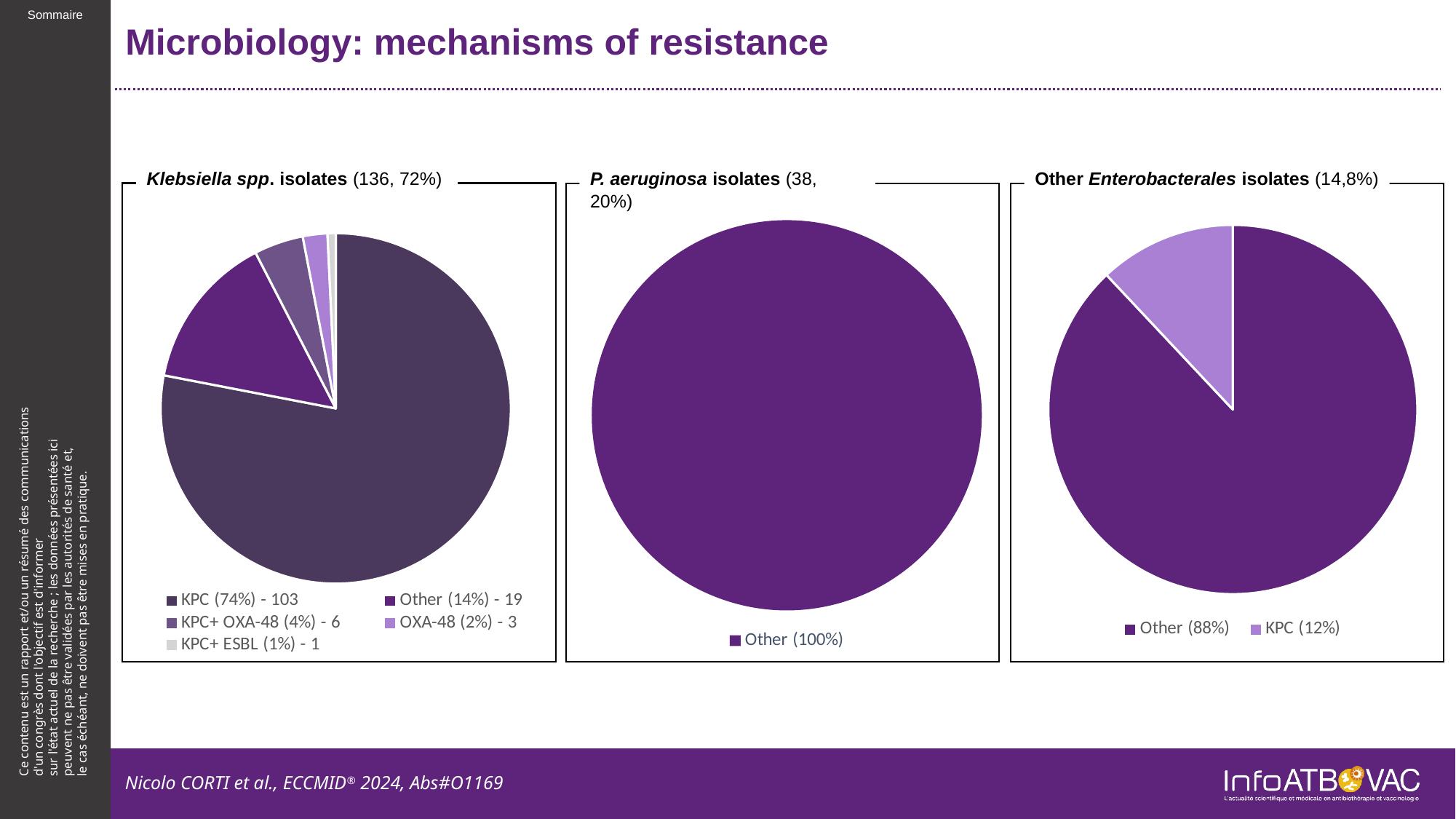
How many isolates are shown in the title of the Klebsiella spp. isolates chart? 136 What kind of chart is the P. aeruginosa isolates chart? Pie chart In the Klebsiella spp. isolates chart, which category has the largest slice? KPC In the P. aeruginosa isolates chart, what share of the pie is Other? 100% In the Klebsiella spp. isolates chart, what share of the pie is the Other slice? 14% In the Klebsiella spp. isolates chart, which is larger: KPC+ OXA-48 or OXA-48? KPC+ OXA-48 In the Klebsiella spp. isolates chart, how many isolates are KPC? 103 In the Other Enterobacterales isolates chart, how many entries does the legend list? 2 In the Klebsiella spp. isolates chart, what is the difference in isolate count between KPC and Other? 84 In the Klebsiella spp. isolates chart, which category has the smallest slice? KPC+ ESBL In the Klebsiella spp. isolates chart, how many slices does the pie have? 5 In the Other Enterobacterales isolates chart, what share of the pie is KPC? 12%